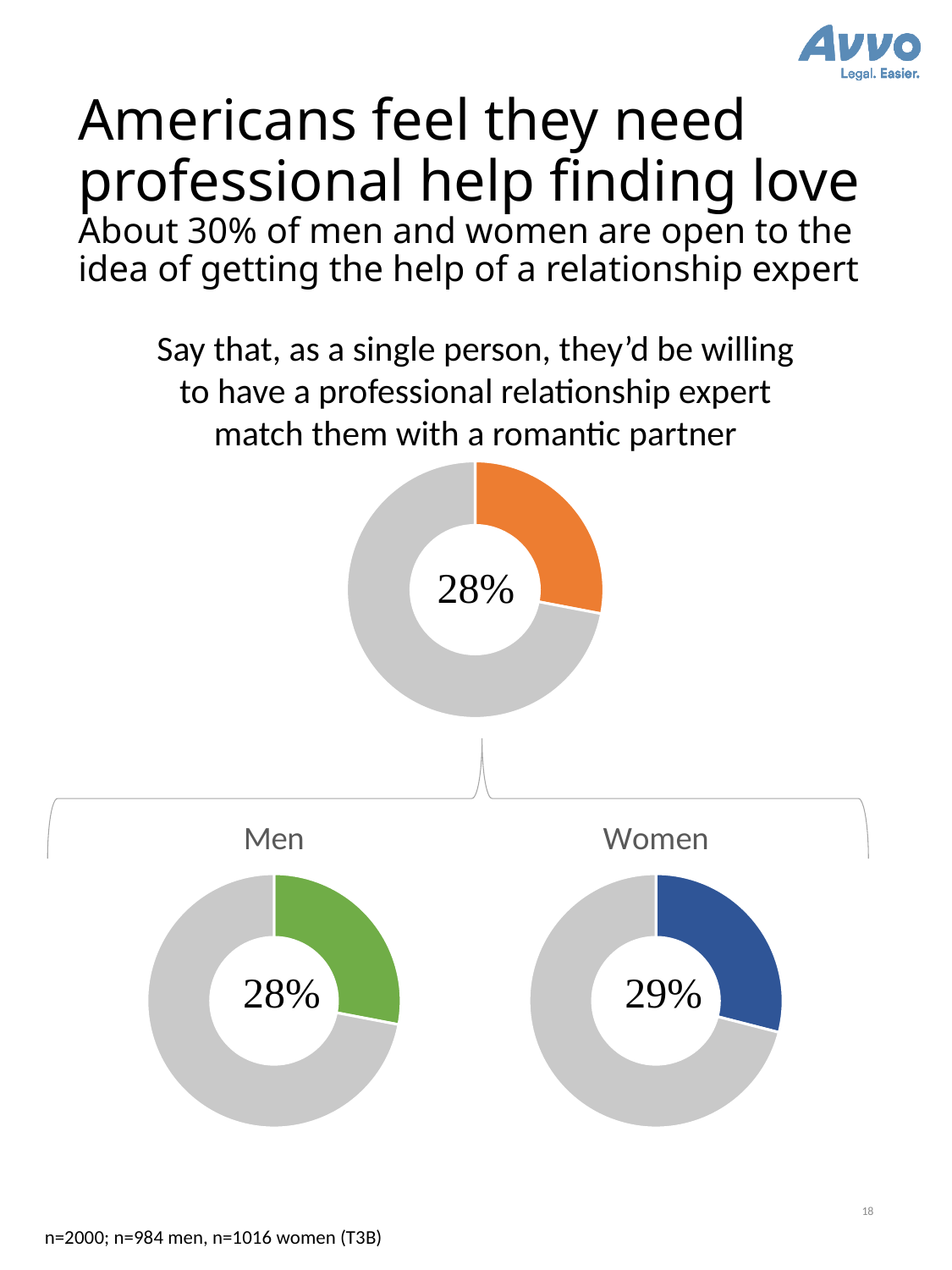
What is the difference in percentage points between the Women donut chart (29%) and the Men donut chart (28%)? 1 percentage point In the Women donut chart, what percentage is shown? 29% How many donut charts are shown on the slide? 3 In the top donut chart, what percentage say they'd be willing to have a professional relationship expert match them with a romantic partner? 28% What kind of chart is used to show the 28% overall figure at the top of the slide? Donut (pie) chart Comparing the Men and Women donut charts, which group has the higher percentage? Women In the Women donut chart, what share of the ring is coloured blue? 29% Which two groups are labelled above the bottom two donut charts? Men and Women In the Men donut chart, what share of the ring is coloured green? 28% What colour is the highlighted slice in the top donut chart? Orange In the Men donut chart, what percentage is shown? 28% Is the value in the Women donut chart greater or less than 50%? less